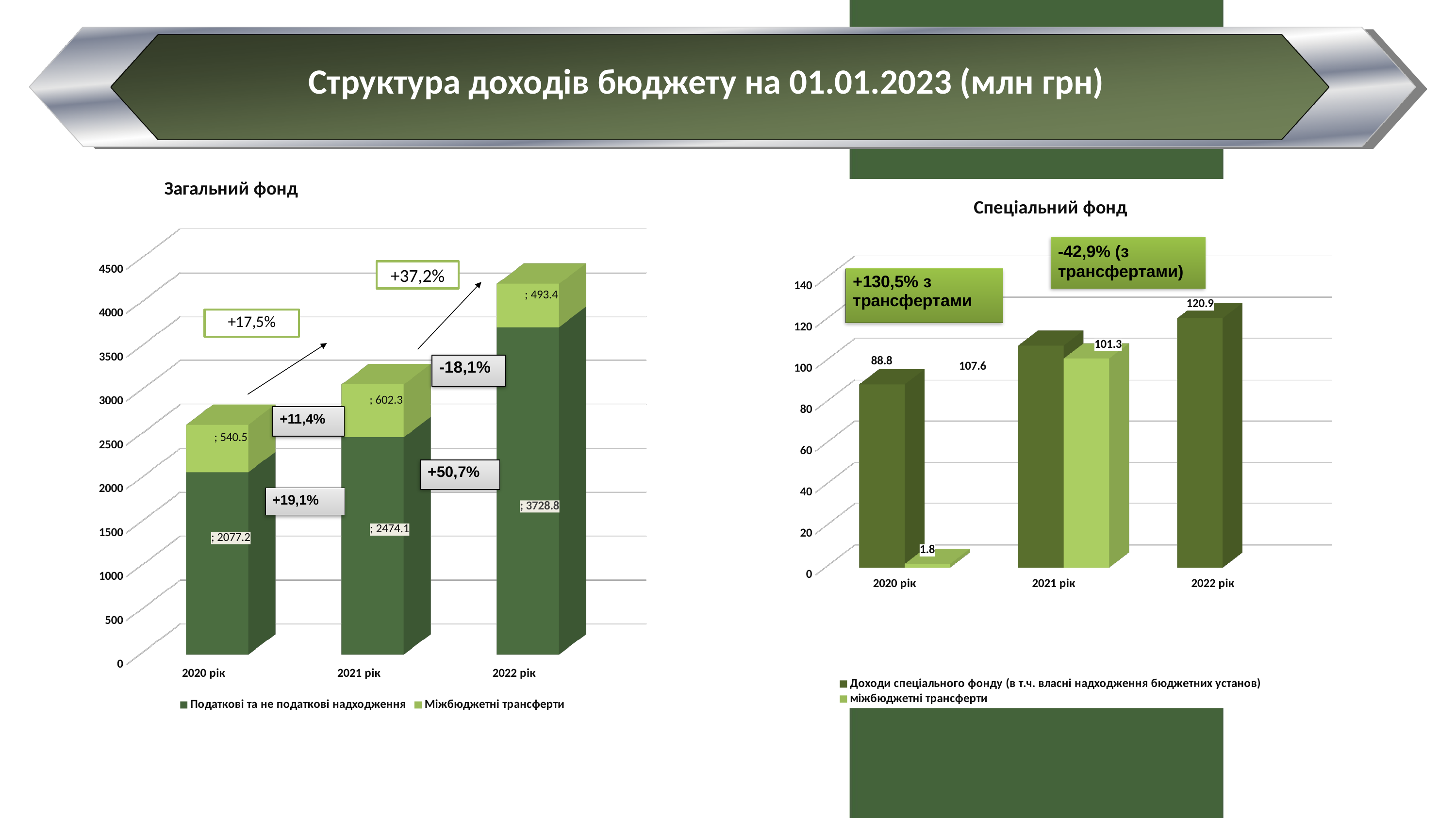
In the 'Загальний фонд' chart, what is the difference between 'Податкові та не податкові надходження' in 2022 рік and 2021 рік? 1254.7 In the 'Загальний фонд' chart, which year has the highest value of 'Міжбюджетні трансферти'? 2021 рік In the 'Спеціальний фонд' chart, what is the difference between 'Доходи спеціального фонду' in 2022 рік and 2020 рік? 32.1 What type of chart is the 'Спеціальний фонд' chart? bar chart In the 'Спеціальний фонд' chart, which year has the lowest value of 'Доходи спеціального фонду'? 2020 рік In the 'Загальний фонд' chart, what is the value of 'Міжбюджетні трансферти' for 2020 рік? 540.5 In the 'Загальний фонд' chart, what is the value of 'Податкові та не податкові надходження' for 2022 рік? 3728.8 In the 'Спеціальний фонд' chart, what is the value of 'Доходи спеціального фонду' for 2021 рік? 107.6 In the 'Загальний фонд' chart, what is the total of the stacked bar for 2021 рік? 3076.4 In the 'Спеціальний фонд' chart, what is the value of 'міжбюджетні трансферти' for 2020 рік? 1.8 In the 'Загальний фонд' chart, how many series does the legend list? 2 In the 'Спеціальний фонд' chart, does 'Доходи спеціального фонду' rise or fall from 2020 рік to 2022 рік? rise